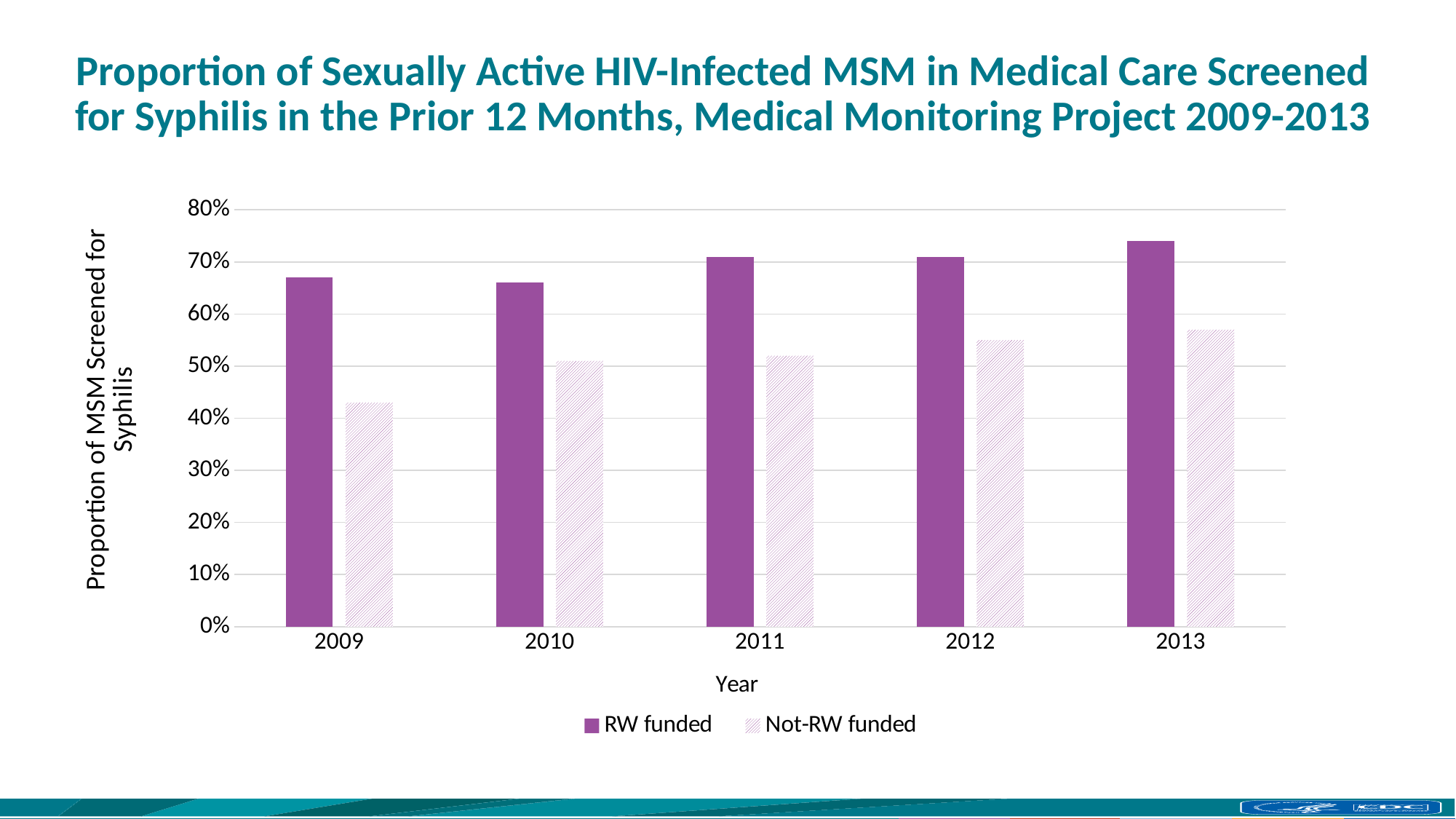
How many years are shown on the x axis? 5 What kind of chart is shown on the slide? bar chart Which year has the lowest value for Not-RW funded? 2009 Is the value for RW funded in 2013 greater or less than 70%? greater In 2011, which is larger: RW funded or Not-RW funded? RW funded Which year has the highest value for RW funded? 2013 Do the Not-RW funded values generally rise or fall from 2009 to 2013? rise Is the value for Not-RW funded in 2009 greater or less than 50%? less Is the value for Not-RW funded in 2012 greater or less than 60%? less What is the label of the y axis? Proportion of MSM Screened for Syphilis How many series does the legend list? 2